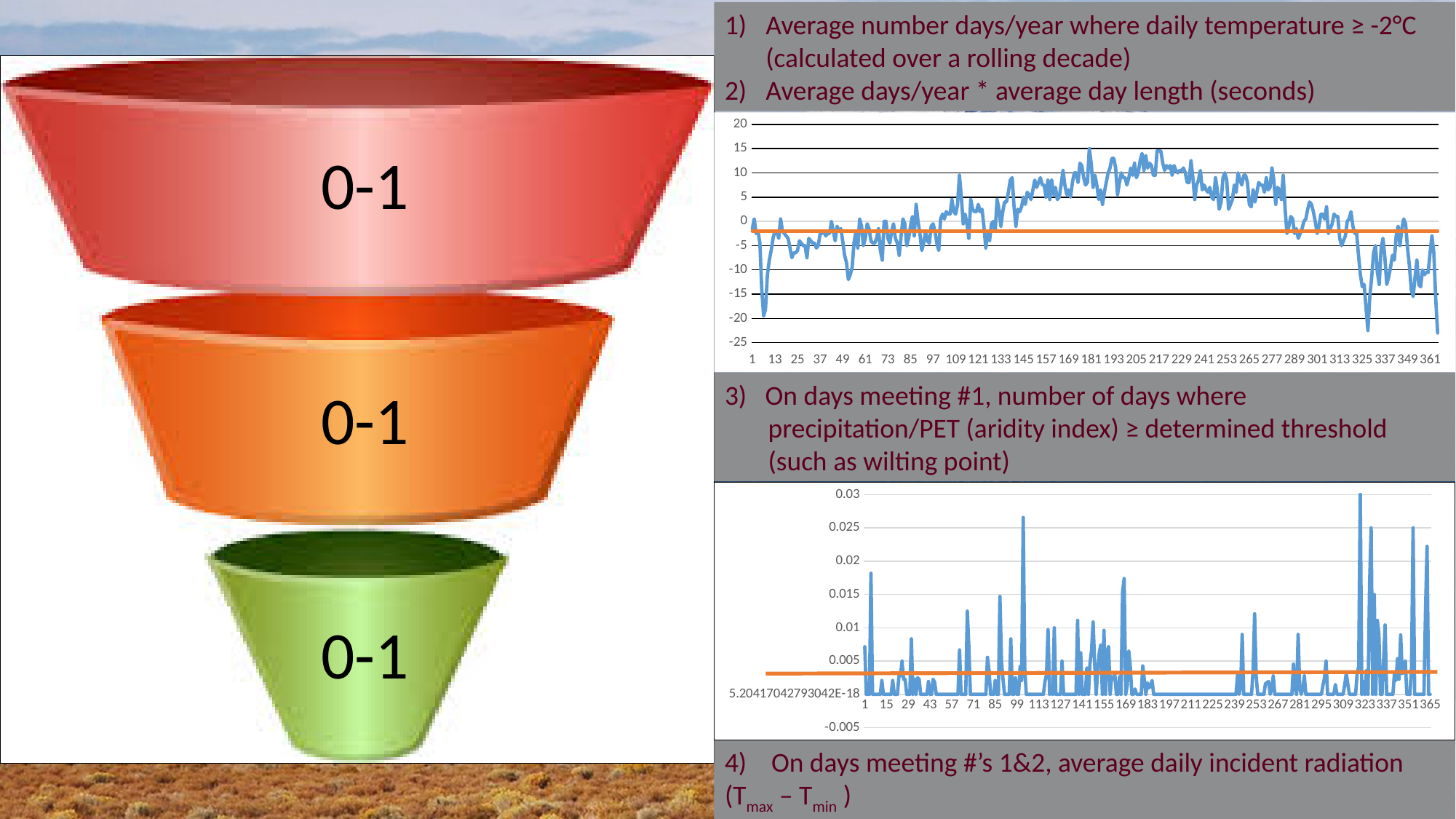
In the lower chart on the right, is the tallest spike near x = 99 greater or less than 0.025? greater In the lower chart on the right, what is the last label on the horizontal axis? 365 In the upper chart on the right, is the peak value of the blue line around x = 181 greater or less than 10? greater In the upper chart on the right, does the blue line generally rise or fall between x = 1 and x = 217? rise In the upper chart on the right, is the lowest value of the blue line near x = 325 greater or less than -20? less In the upper chart on the right, what is the highest value shown on the vertical axis? 20 What kind of chart is the upper chart on the right side of the slide? line chart What kind of chart is the lower chart on the right side of the slide? line chart In the upper chart on the right, what is the lowest value shown on the vertical axis? -25 In the upper chart on the right, does the blue line generally rise or fall between x = 217 and x = 361? fall